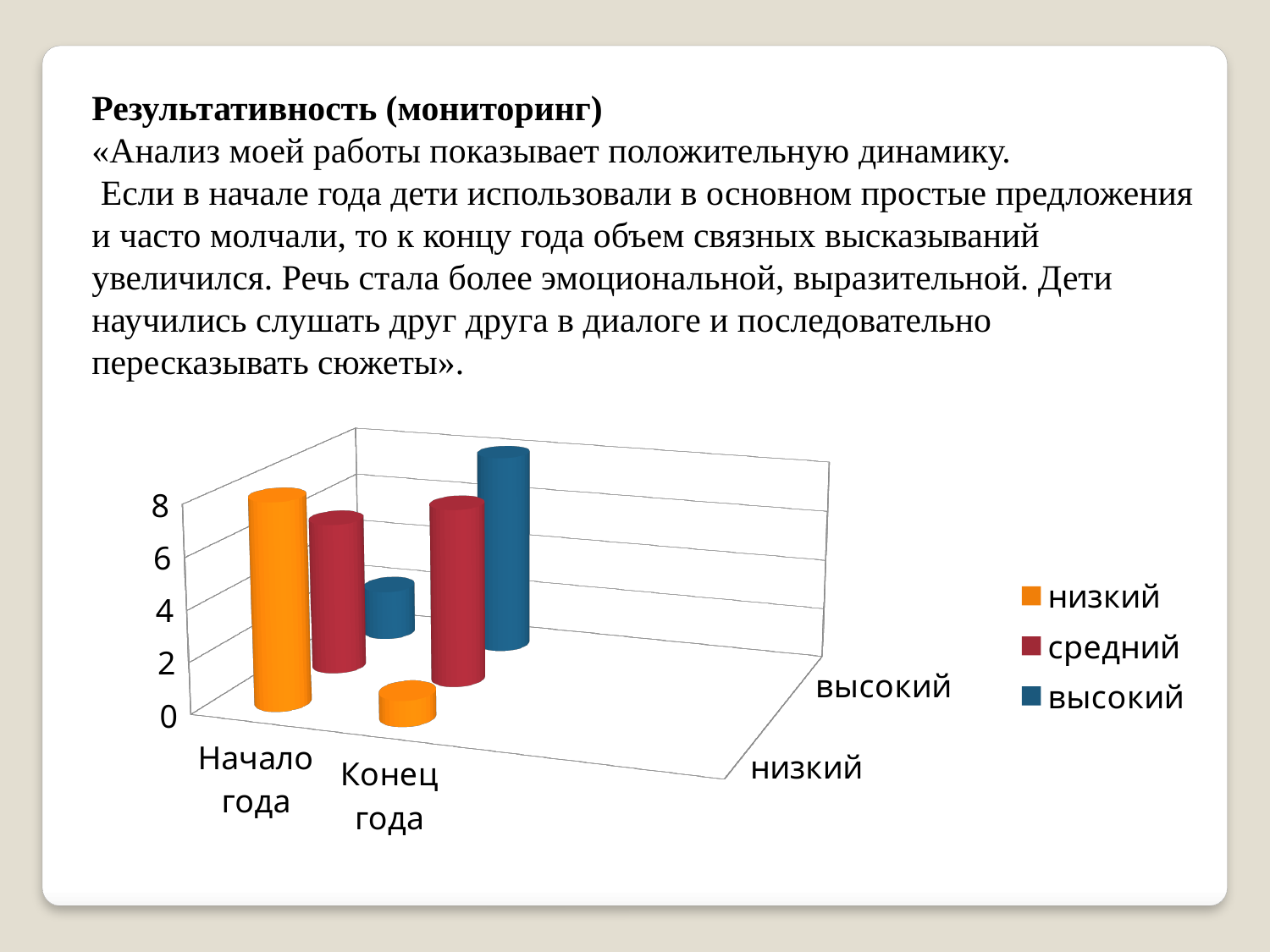
How many categories are shown on the x axis? 2 Which series has the highest value for Начало года? низкий Is the value for низкий at Конец года greater or less than 2? less Which series has the lowest value for Начало года? высокий Which is larger: the value for высокий at Начало года or at Конец года? Конец года Which series has the highest value for Конец года? высокий Is the value for низкий at Начало года greater or less than 4? greater How many series does the legend list? 3 Does the value for низкий rise or fall from Начало года to Конец года? fall Is the value for высокий at Конец года greater or less than 6? greater What kind of chart is shown on the slide? bar chart Which series has the lowest value for Конец года? низкий